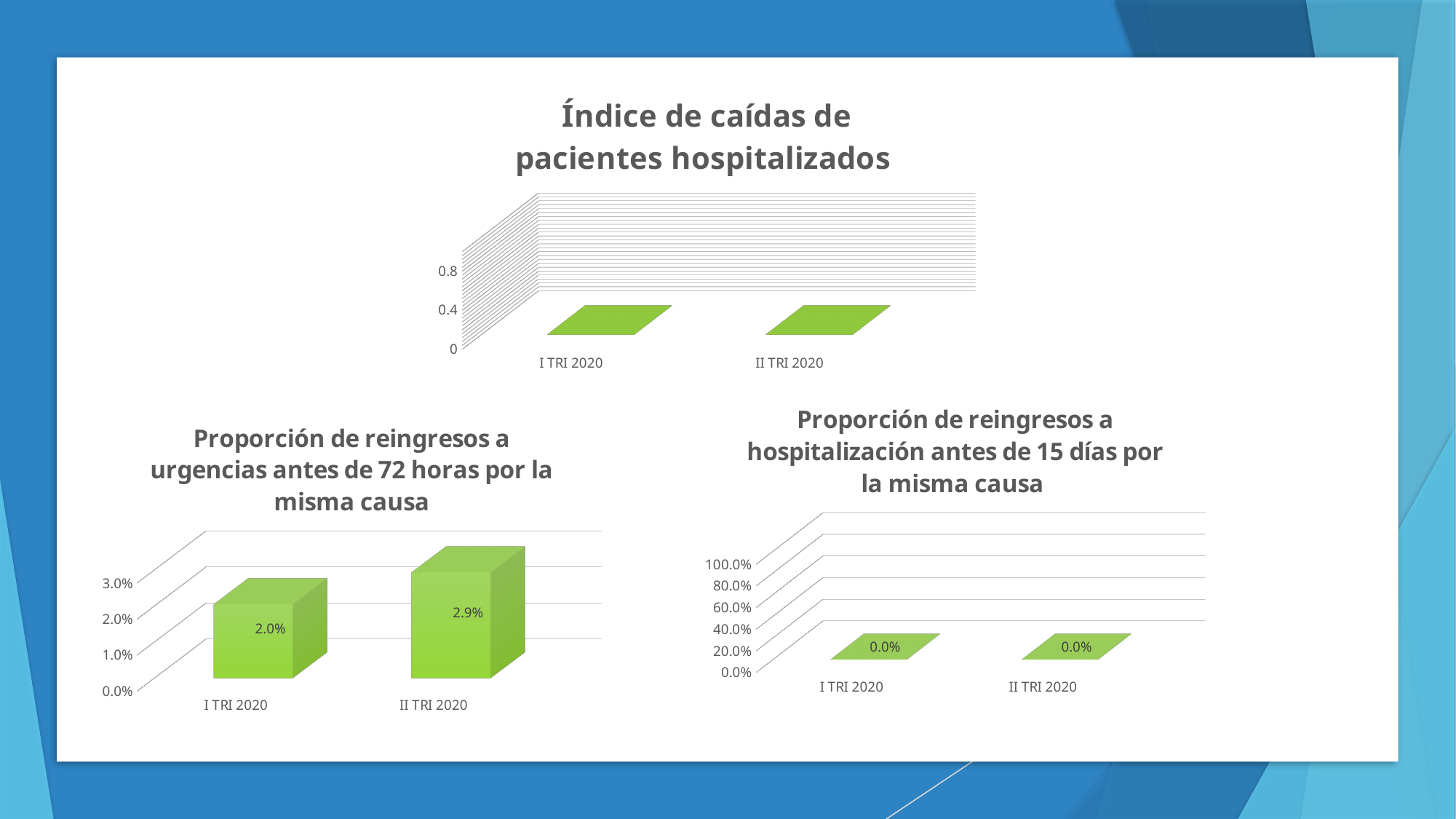
How many charts are shown on the slide? 3 In the chart 'Proporción de reingresos a hospitalización antes de 15 días por la misma causa', what is the value for II TRI 2020? 0.0% In the chart 'Proporción de reingresos a urgencias antes de 72 horas por la misma causa', do the values rise or fall from I TRI 2020 to II TRI 2020? rise In the chart 'Proporción de reingresos a urgencias antes de 72 horas por la misma causa', which period has the lowest value? I TRI 2020 In the chart 'Proporción de reingresos a urgencias antes de 72 horas por la misma causa', what is the difference between the II TRI 2020 and I TRI 2020 values? 0.9% In the chart 'Proporción de reingresos a urgencias antes de 72 horas por la misma causa', what is the value for II TRI 2020? 2.9% In the chart 'Índice de caídas de pacientes hospitalizados', is the value for I TRI 2020 greater or less than 0.4? less In the chart 'Proporción de reingresos a hospitalización antes de 15 días por la misma causa', what is the value for I TRI 2020? 0.0% In the chart 'Proporción de reingresos a urgencias antes de 72 horas por la misma causa', what is the value for I TRI 2020? 2.0% What kind of chart is 'Proporción de reingresos a urgencias antes de 72 horas por la misma causa'? bar chart In the chart 'Proporción de reingresos a urgencias antes de 72 horas por la misma causa', which period has the highest value? II TRI 2020 How many categories are shown in the chart 'Índice de caídas de pacientes hospitalizados'? 2